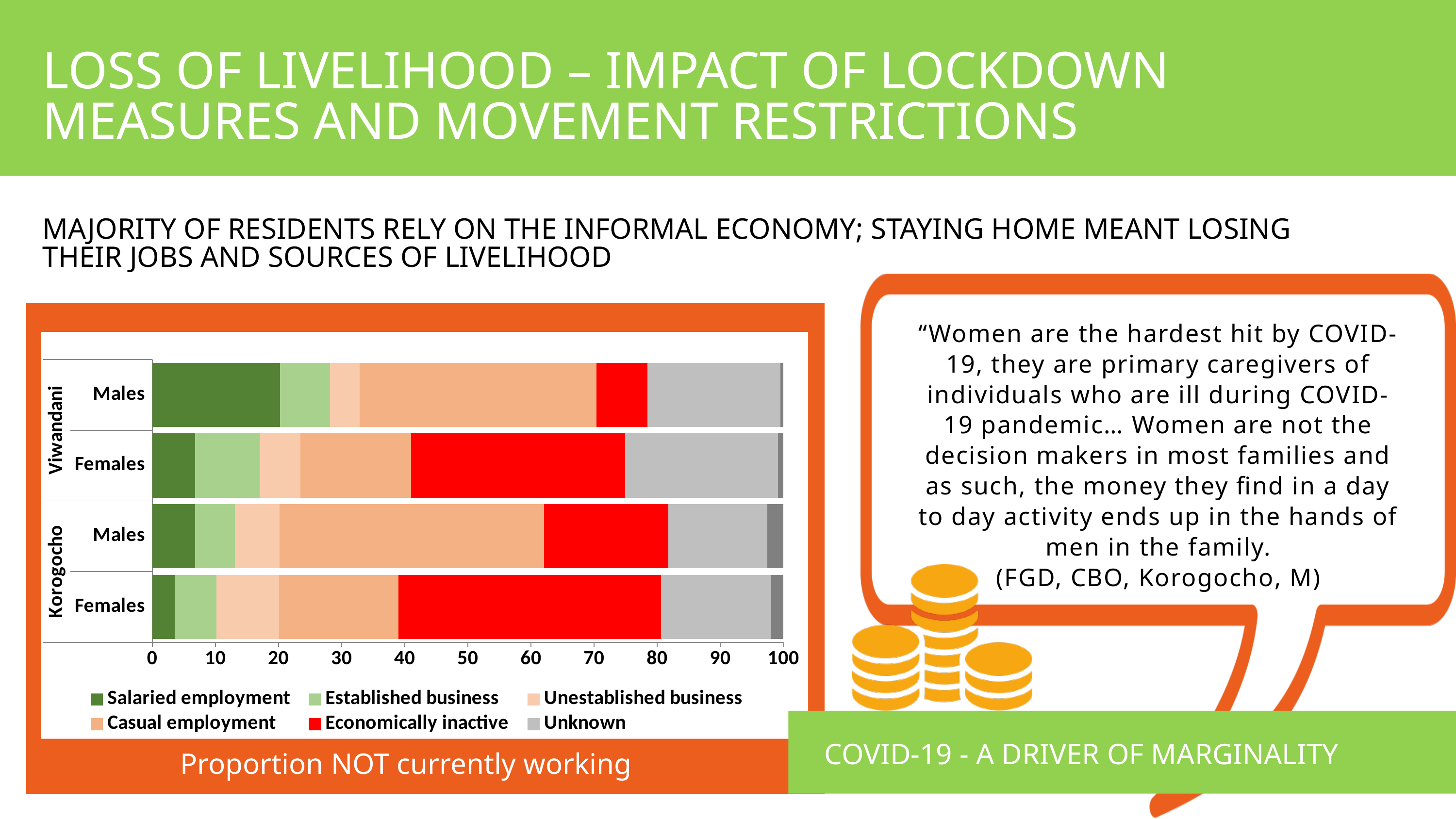
Which bar has the largest Salaried employment segment? Viwandani Males Which is larger: the Casual employment segment for Korogocho Males or for Viwandani Females? Korogocho Males Is the Economically inactive segment for Korogocho Females greater or less than 30? greater Is the Salaried employment segment for Viwandani Males greater or less than 10? greater What is the caption printed below the chart? Proportion NOT currently working Which bar has the smallest Salaried employment segment? Korogocho Females Which bar has the largest Economically inactive segment? Korogocho Females Which is larger: the Economically inactive segment for Viwandani Males or for Viwandani Females? Viwandani Females Which colour represents the Economically inactive series in the chart? Red How many series does the chart legend list? 6 What kind of chart is shown on the slide? Stacked bar chart How many bars are plotted in the chart? 4